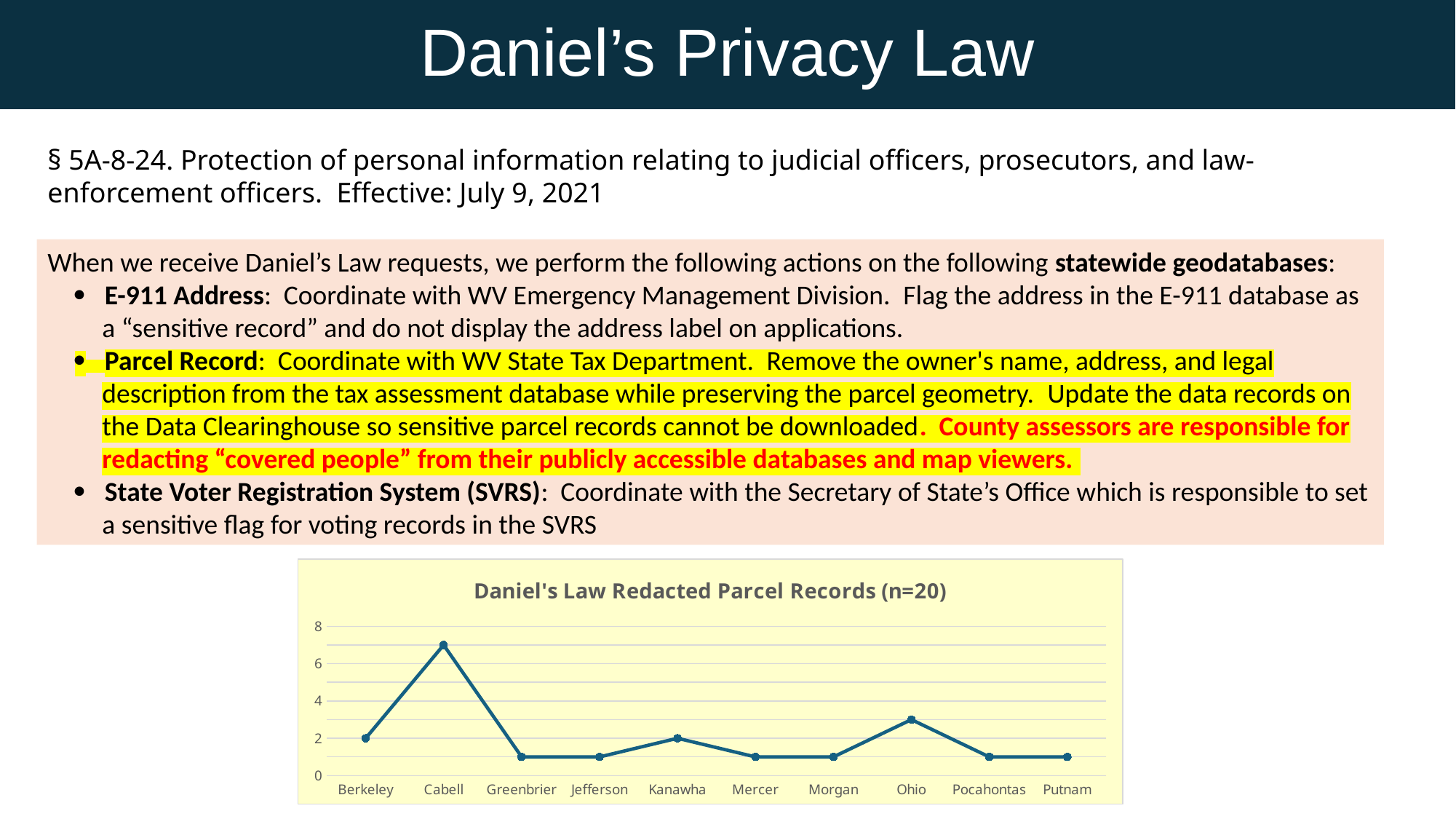
What type of chart is shown on the slide? line chart What is the value for Berkeley? 2 Which county has the highest number of redacted parcel records? Cabell What is the title of the chart? Daniel's Law Redacted Parcel Records (n=20) Is the value for Ohio greater or less than 4? less What is the value for Kanawha? 2 Which county has a larger value, Ohio or Berkeley? Ohio How many counties are plotted along the x axis of the chart? 10 Is the value for Greenbrier greater or less than 2? less Is the value for Cabell greater or less than 6? greater Does the line rise or fall from Berkeley to Cabell? rise Which county has a larger value, Cabell or Ohio? Cabell